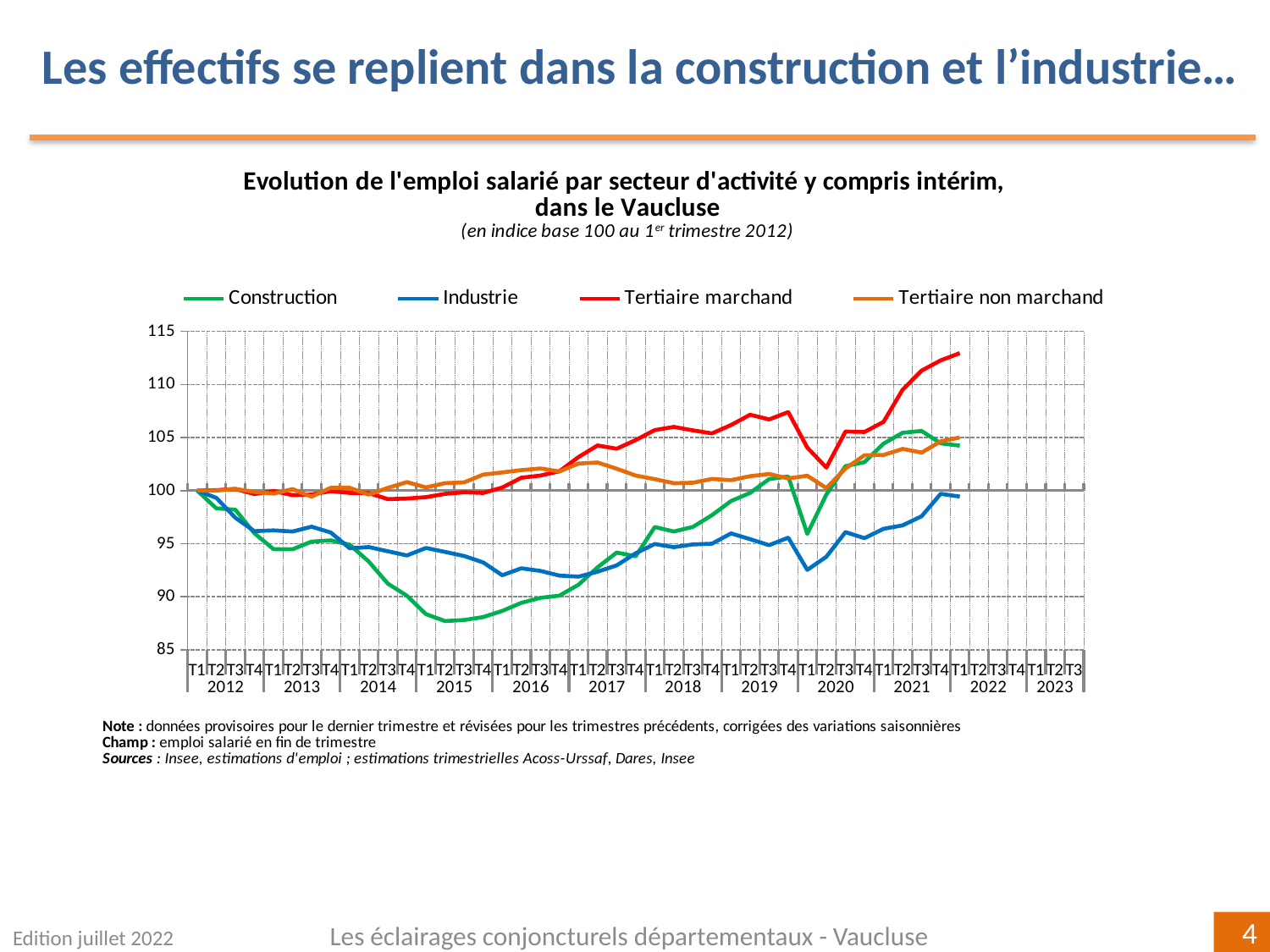
Is the value for Tertiaire marchand in T1 2022 greater or less than 110? greater Is the value for Construction in T2 2015 greater or less than 90? less Does the Construction series rise or fall between T1 2012 and T2 2015? fall Which series reaches the lowest value anywhere on the chart? Construction Is the value for Industrie in T1 2020 greater or less than 95? less What is the base of the index used in the chart, according to the subtitle? base 100 au 1er trimestre 2012 What kind of chart is shown on the slide? line chart How many series does the legend list? 4 Which series has the lowest value at the last plotted point (T1 2022)? Industrie Which series are listed in the legend? Construction, Industrie, Tertiaire marchand, Tertiaire non marchand Which series has the highest value at the last plotted point (T1 2022)? Tertiaire marchand